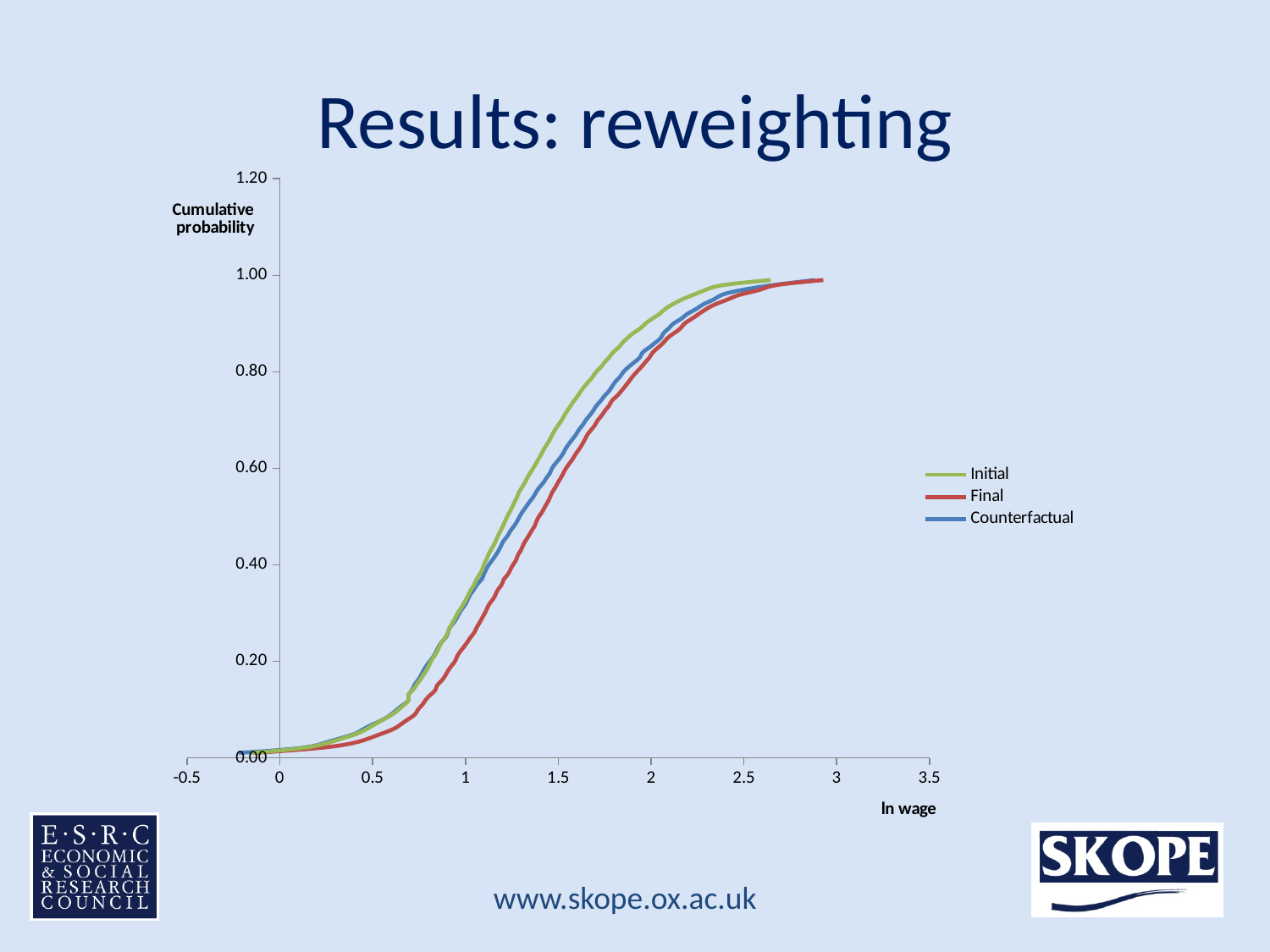
How many series does the legend list? 3 At ln wage 2, is the value of the Initial series greater or less than 0.80? greater At ln wage 1.5, which series has the higher cumulative probability, Initial or Final? Initial Do the plotted lines rise or fall as ln wage increases? rise At ln wage 0.5, is the value of the Final series greater or less than 0.20? less What is the highest tick value shown on the vertical axis? 1.20 At ln wage 1.5, is the value of the Initial series greater or less than 0.60? greater What label is given to the horizontal axis of the chart? ln wage Which series reaches its maximum cumulative probability at the lowest ln wage? Initial What kind of chart is shown on the slide? line chart What is the title of the slide's chart? Results: reweighting